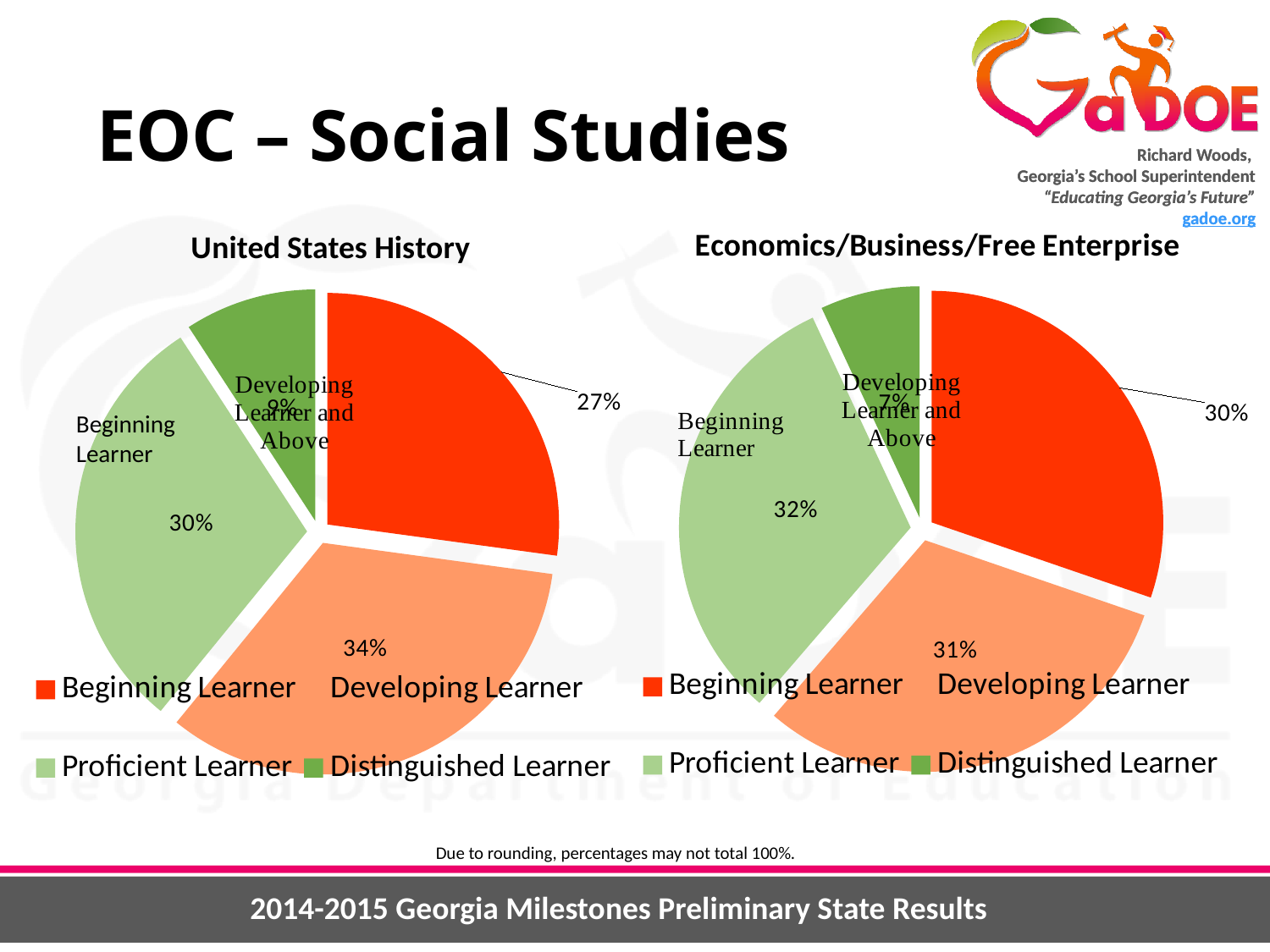
In the United States History chart, which achievement level has the smallest share? Distinguished Learner In the United States History chart, what percentage of students are Beginning Learners? 27% In the Economics/Business/Free Enterprise chart, which achievement level has the smallest share? Distinguished Learner In the United States History chart, which achievement level has the largest share? Developing Learner In the United States History chart, what percentage of students are Developing Learners? 34% In the United States History chart, how many percentage points larger is the Developing Learner share than the Beginning Learner share? 7 percentage points Which chart shows a larger Beginning Learner share, United States History or Economics/Business/Free Enterprise? Economics/Business/Free Enterprise In the Economics/Business/Free Enterprise chart, what percentage of students are Beginning Learners? 30% In the Economics/Business/Free Enterprise chart, what percentage of students are Proficient Learners? 32% In the United States History chart, what percentage of students are Proficient Learners? 30% What type of chart is used for the United States History results? Pie chart In the Economics/Business/Free Enterprise chart, what percentage of students are Developing Learners? 31%